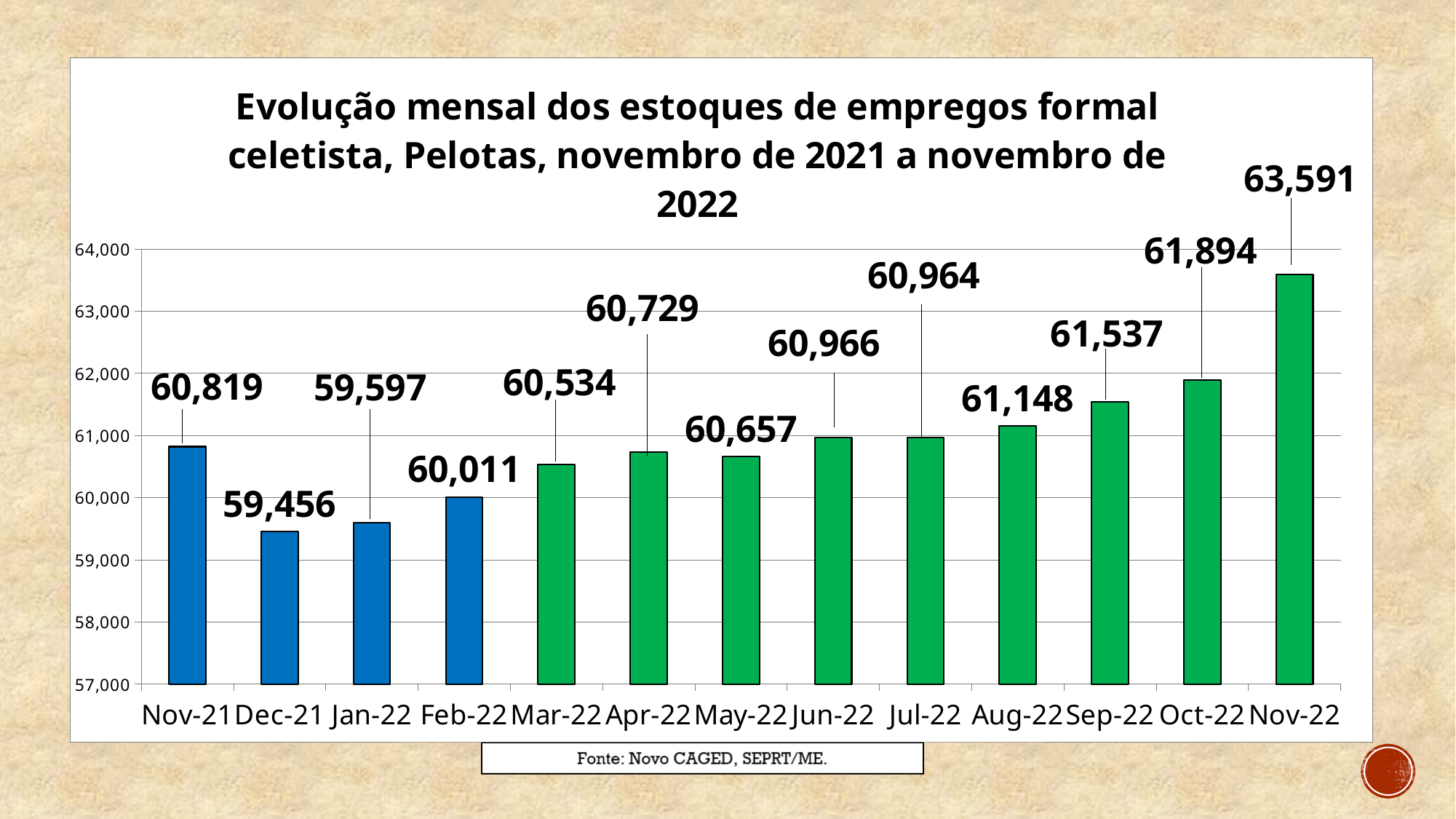
What is the value for Dec-21? 59,456 Do the values rise or fall from Mar-22 to Nov-22? rise What is the difference between the values for Oct-22 and Nov-22? 1,697 What is the value for Nov-22? 63,591 Which month has the highest value? Nov-22 Which month has the lowest value? Dec-21 Is the value for Dec-21 greater or less than 60,000? less What is the value for Jun-22? 60,966 What is the difference between the values for Nov-22 and Nov-21? 2,772 What kind of chart is shown on the slide? bar chart How many months are shown on the x axis? 13 Which is larger, the value for Nov-21 or the value for Feb-22? Nov-21